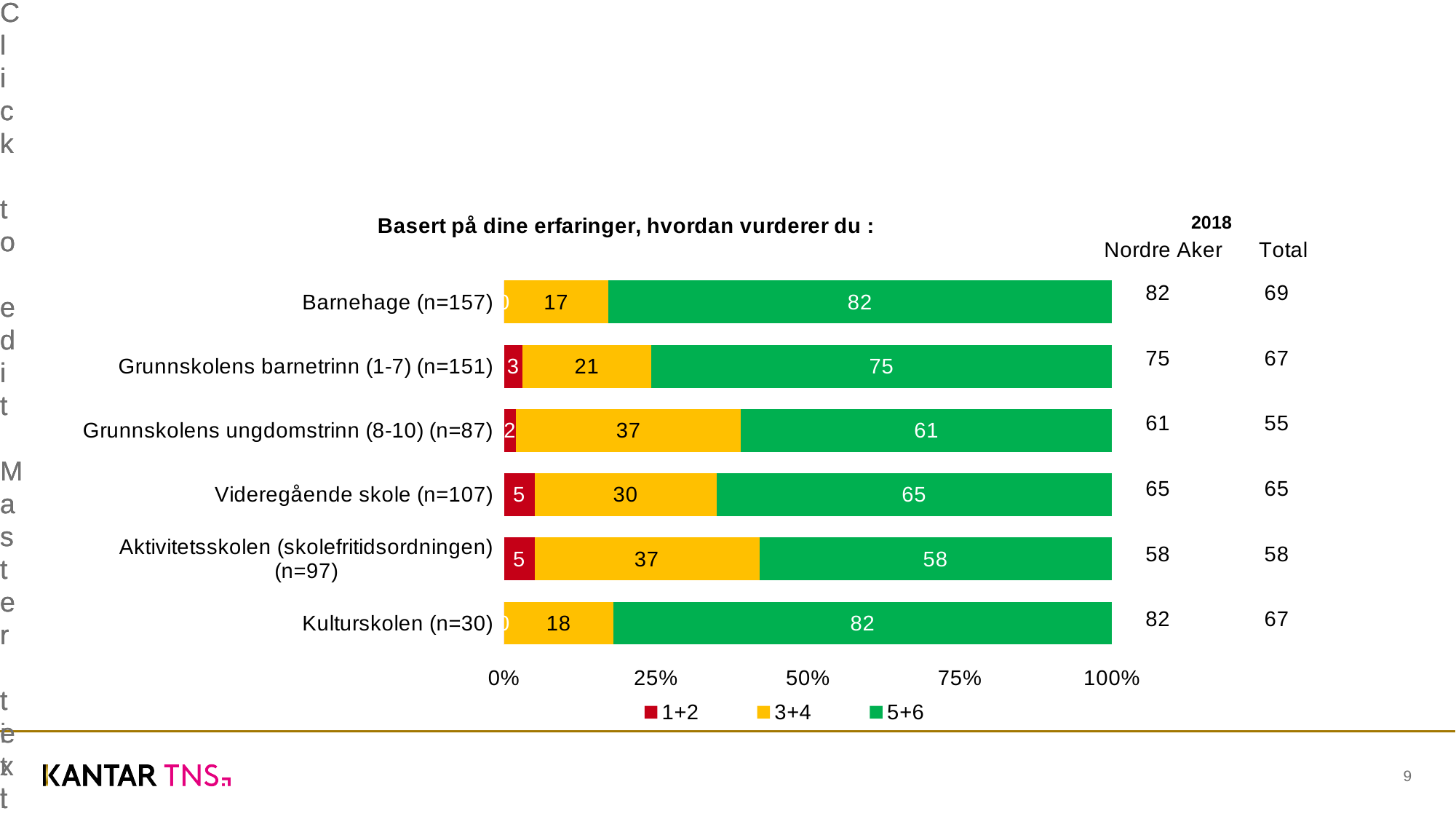
What is the difference between the 5+6 values for Grunnskolens barnetrinn (1-7) (n=151) and Grunnskolens ungdomstrinn (8-10) (n=87)? 14 What is the value of the 1+2 series for Videregående skole (n=107)? 5 How many series does the legend list? 3 Is the 5+6 value for Videregående skole (n=107) greater or less than 50? greater How many categories are shown on the chart? 6 What is the value of the 5+6 series for Barnehage (n=157)? 82 What is the 3+4 value for Kulturskolen (n=30)? 18 Which category has the highest value for the 3+4 series, Grunnskolens barnetrinn (1-7) (n=151) or Videregående skole (n=107)? Videregående skole (n=107) What kind of chart is shown on the slide? Stacked bar chart What is the title of the chart? Basert på dine erfaringer, hvordan vurderer du : Which category has the lowest value for the 5+6 series? Aktivitetsskolen (skolefritidsordningen) (n=97) What is the value of the 3+4 series for Grunnskolens ungdomstrinn (8-10) (n=87)? 37